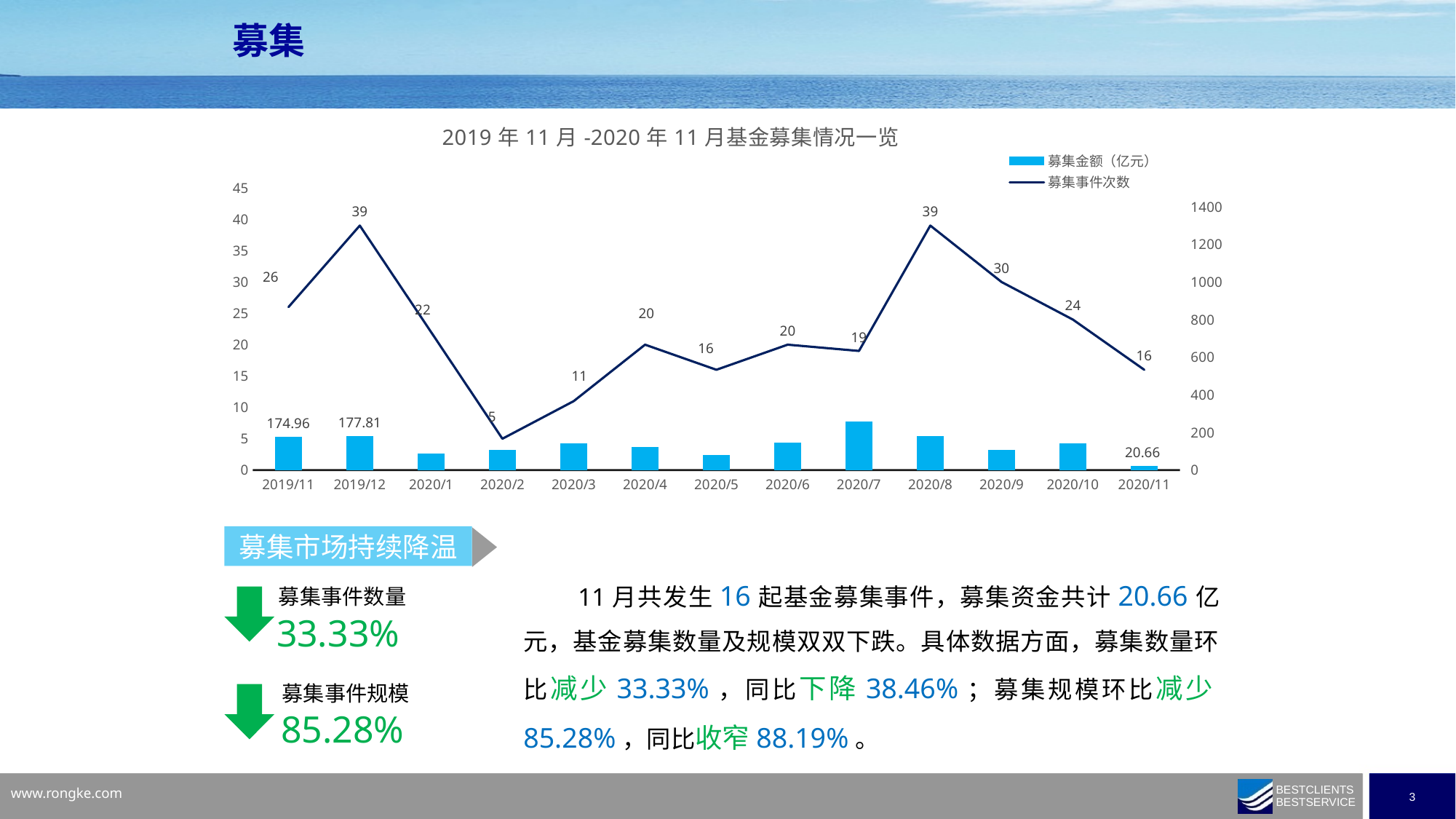
Which month has the lowest 募集事件次数? 2020/2 What is the 募集金额（亿元） value for 2019/12? 177.81 Does the 募集事件次数 line rise or fall from 2020/8 to 2020/11? fall How many series does the legend list? 2 Which month has a higher 募集事件次数, 2020/4 or 2020/5? 2020/4 How many months are shown on the x axis? 13 Is the 募集金额（亿元） bar for 2020/7 greater or less than 400? less What is the 募集金额（亿元） value for 2020/11? 20.66 What kind of chart is this? Combination bar and line chart What is the 募集事件次数 value for 2020/2? 5 What is the difference in 募集事件次数 between 2020/8 and 2020/11? 23 What is the difference in 募集金额（亿元） between 2019/12 and 2019/11? 2.85